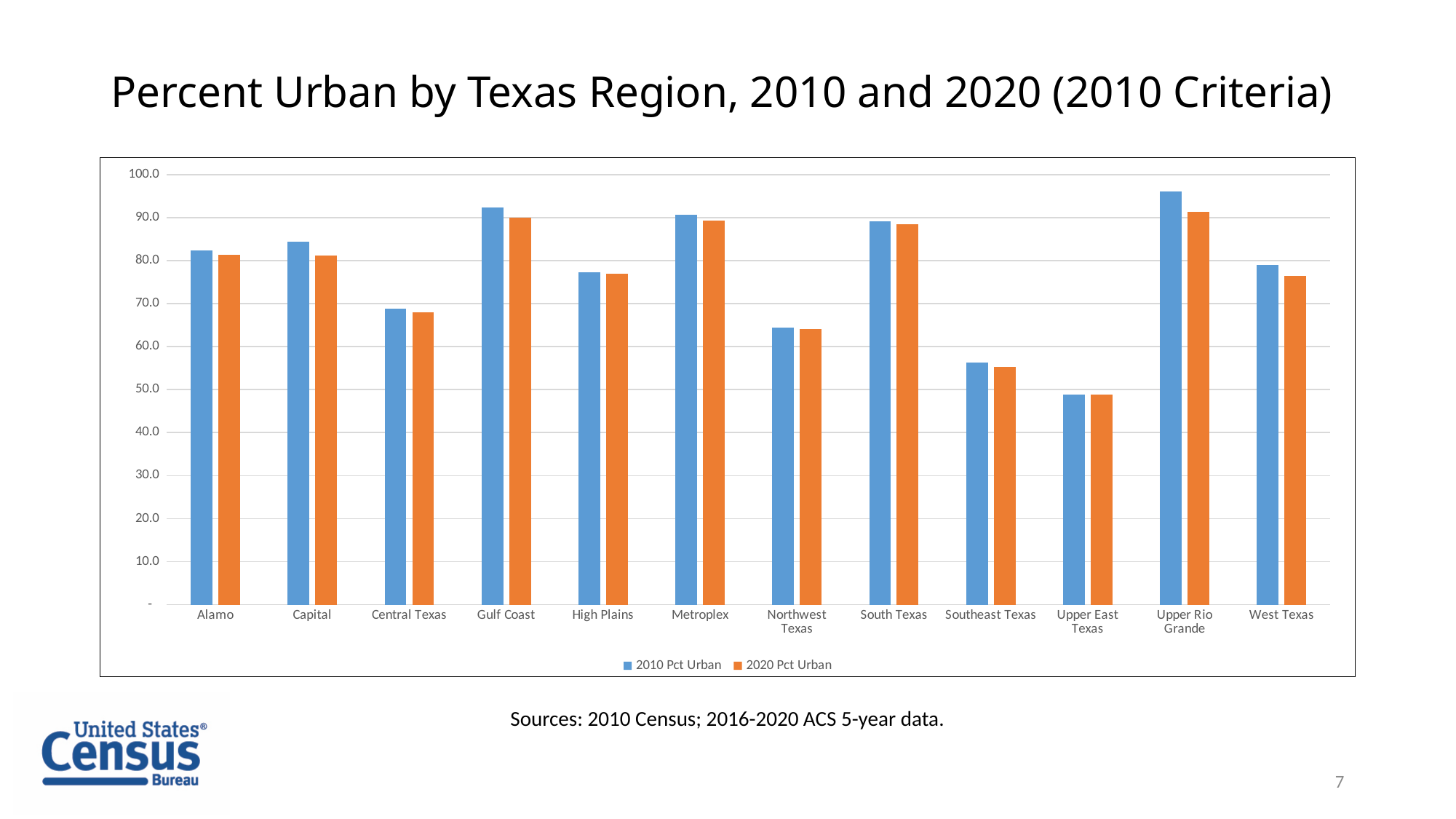
How many Texas regions are shown on the x axis? 12 What is the title of the chart on the slide? Percent Urban by Texas Region, 2010 and 2020 (2010 Criteria) How many series does the legend list? 2 What kind of chart is shown on the slide? bar chart Is the 2010 Pct Urban value for Upper East Texas greater or less than 50.0? less Is the 2020 Pct Urban value for Southeast Texas greater or less than 50.0? greater For Upper Rio Grande, which is larger: the 2010 Pct Urban value or the 2020 Pct Urban value? 2010 Pct Urban Which region has the highest 2010 Pct Urban value? Upper Rio Grande Is the 2010 Pct Urban value for Gulf Coast greater or less than 90.0? greater Which is larger: the 2010 Pct Urban value for Upper Rio Grande or for Gulf Coast? Upper Rio Grande Which region has the lowest 2020 Pct Urban value? Upper East Texas